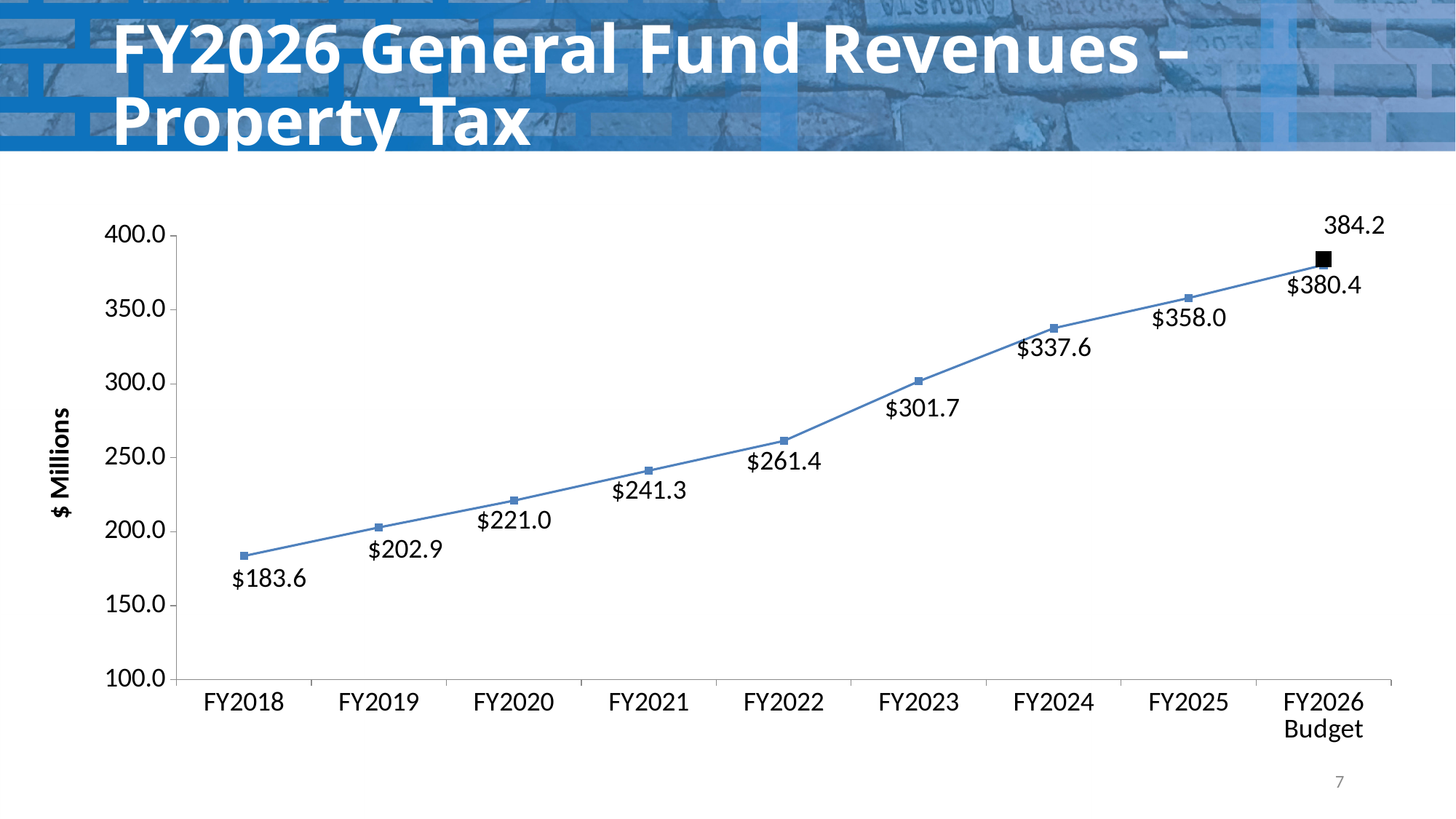
Which fiscal year has the lowest value on the chart? FY2018 What is the difference between the FY2023 value and the FY2022 value on the blue line? $40.3 What is the difference between the FY2025 value ($358.0) and the FY2018 value ($183.6)? $174.4 Do the values rise or fall from FY2018 to FY2026 Budget? Rise Which is larger, the value for FY2020 or the value for FY2022? FY2022 What is the value labeled on the blue line for FY2023? $301.7 What kind of chart is shown on the slide? Line chart Which fiscal year has the highest value on the chart? FY2026 Budget What is the property tax revenue value shown for FY2018? $183.6 What value is labeled next to the black square marker at FY2026 Budget? 384.2 How many fiscal years are shown on the x axis? 9 What is the value labeled on the blue line for FY2025? $358.0